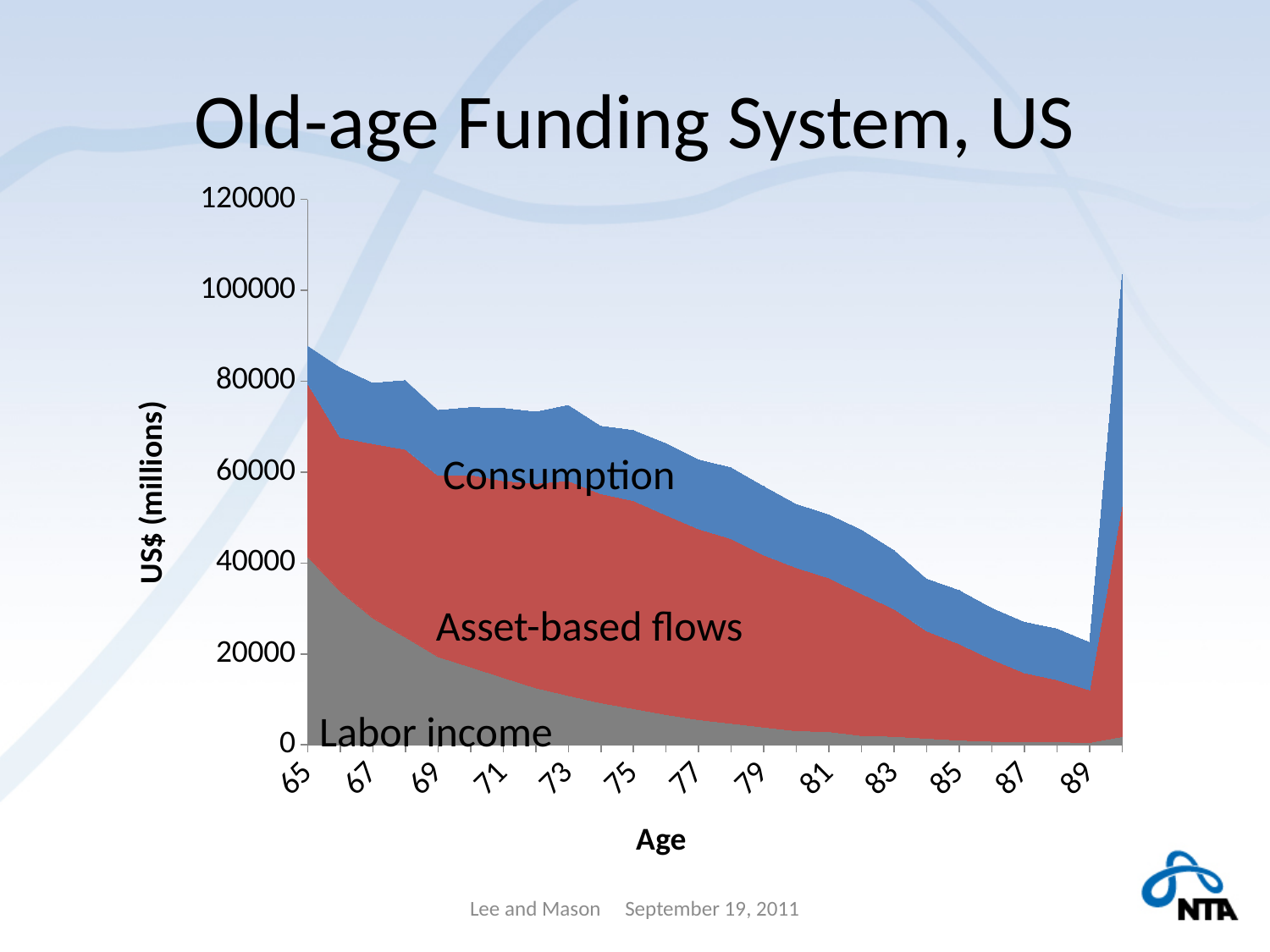
Does the Labor income area rise or fall as age increases from 65 to 89? fall Is the total stacked value at age 81 greater or less than 60000? less Is the total stacked value at age 89 greater or less than 40000? less How many series (labeled areas) are plotted in the chart? 3 Which series is the smallest at age 65? Consumption What is the label of the vertical axis? US$ (millions) What is the title of the chart? Old-age Funding System, US Which series is the largest at age 85? Asset-based flows Is the total stacked value at age 65 greater or less than 80000? greater What is the highest value shown on the vertical axis? 120000 What kind of chart is shown on the slide? Stacked area chart